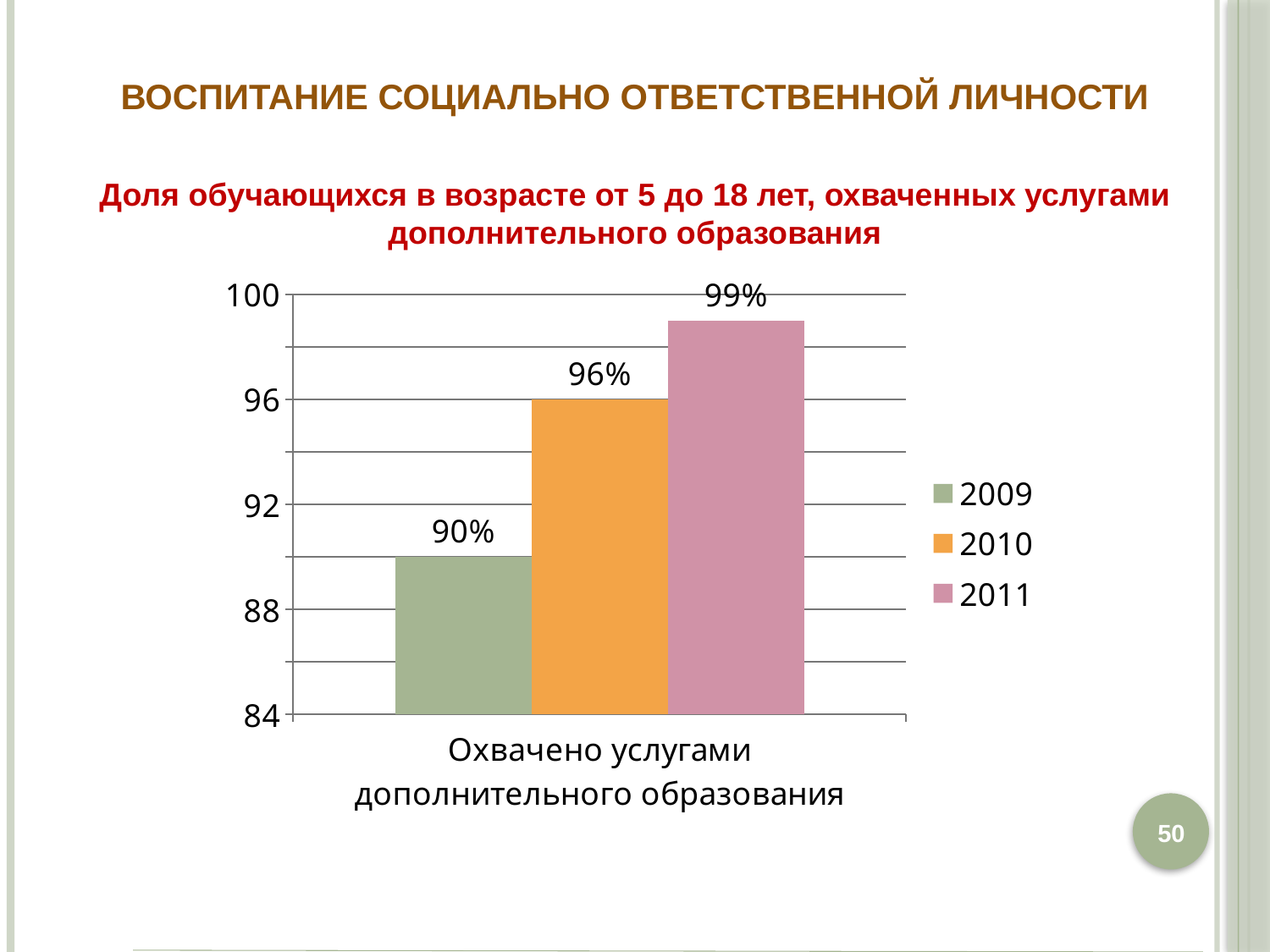
Is the value for 2009 greater or less than 92? less How many series does the legend list? 3 What is the value for 2011 in the chart? 99% Which year has the highest value in the chart? 2011 What is the value for 2010 in the chart? 96% What is the value for 2009 in the chart? 90% Which year has the lowest value in the chart? 2009 What is the difference between the values for 2011 and 2009? 9% Do the values rise or fall from 2009 to 2011? rise What kind of chart is shown on the slide? bar chart What is the difference between the values for 2010 and 2009? 6% Which is larger, the value for 2010 or the value for 2011? 2011